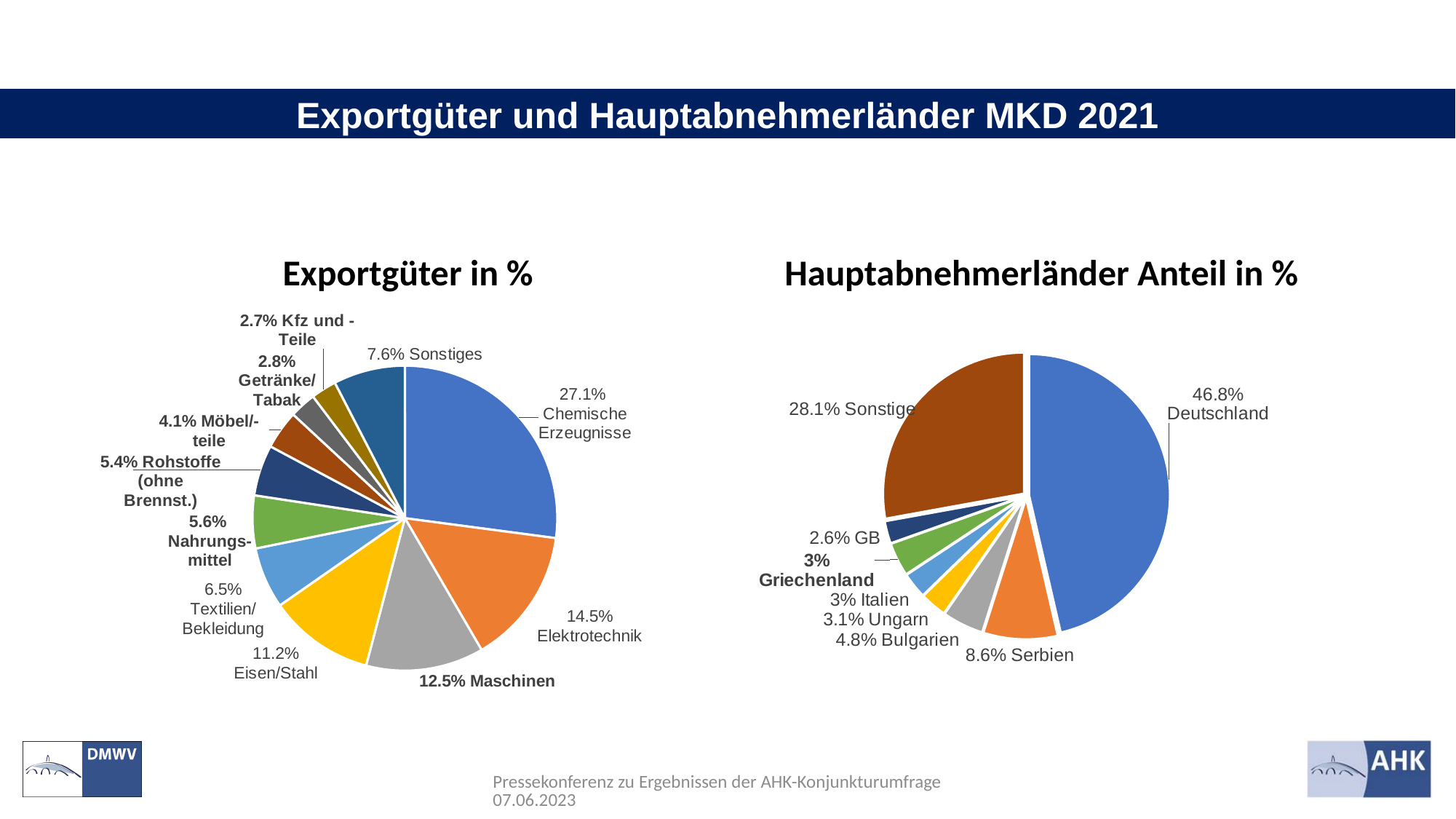
In the 'Exportgüter in %' chart, which named export good category (excluding Sonstiges) has the smallest share? Kfz und -Teile In the 'Hauptabnehmerländer Anteil in %' chart, what is the share for GB? 2.6% In the 'Exportgüter in %' chart, which is larger: Textilien/Bekleidung or Nahrungsmittel? Textilien/Bekleidung How many slices does the 'Exportgüter in %' pie chart have? 11 In the 'Exportgüter in %' chart, what is the share for Eisen/Stahl? 11.2% In the 'Hauptabnehmerländer Anteil in %' chart, what is the difference between the shares of Serbien and Bulgarien? 3.8% In the 'Hauptabnehmerländer Anteil in %' chart, what share does Deutschland have? 46.8% What type of chart is 'Hauptabnehmerländer Anteil in %'? Pie chart How many slices does the 'Hauptabnehmerländer Anteil in %' pie chart have? 8 In the 'Hauptabnehmerländer Anteil in %' chart, which country has the largest share? Deutschland In the 'Exportgüter in %' chart, what is the difference between the shares of Elektrotechnik and Maschinen? 2.0% In the 'Exportgüter in %' chart, what share do Chemische Erzeugnisse have? 27.1%